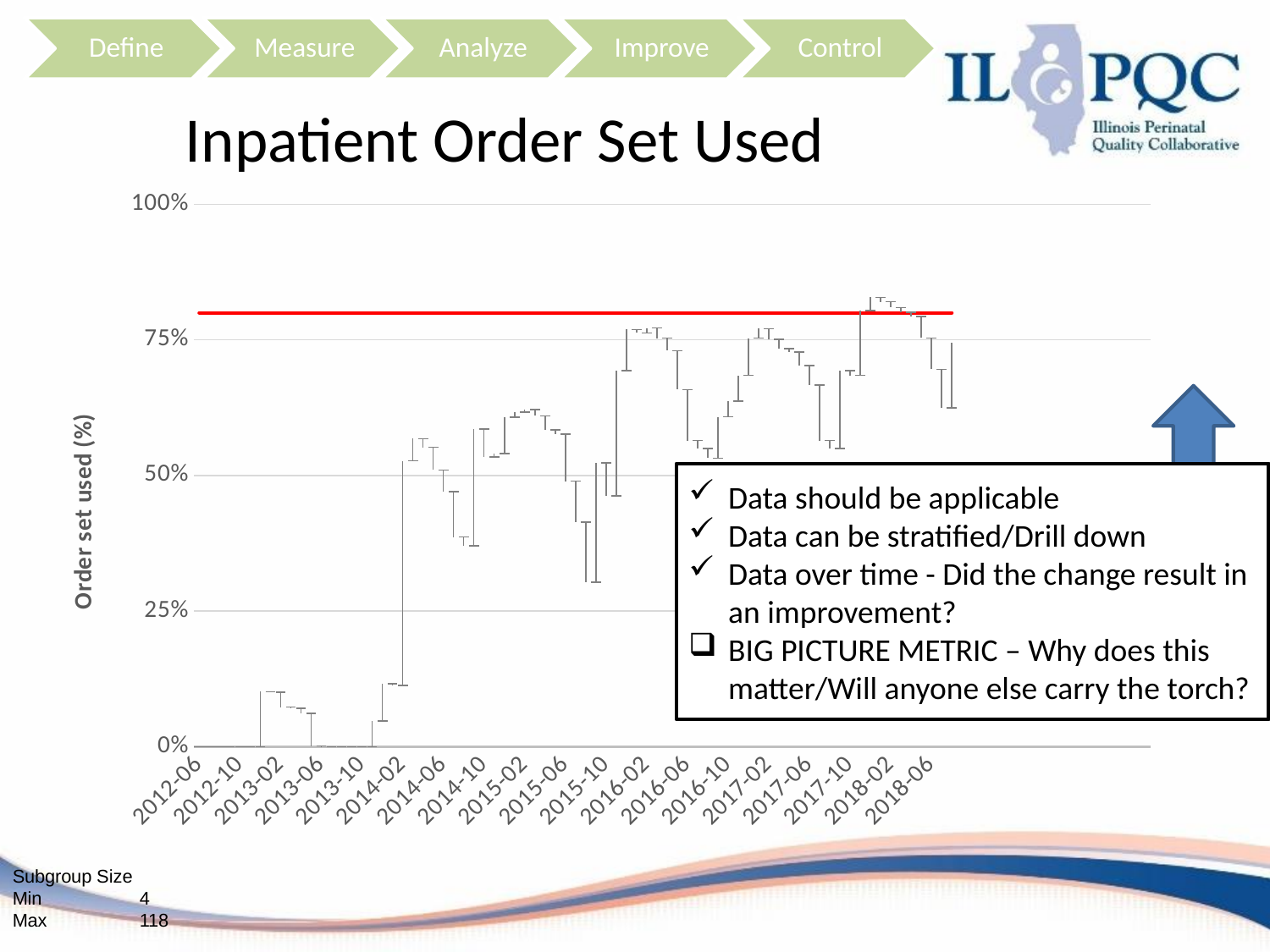
What is the last date label on the horizontal axis of the chart? 2018-06 Is the value for 2018-02 greater or less than 75%? greater What is the maximum subgroup size listed on the slide? 118 What is the label of the vertical axis of the chart? Order set used (%) What kind of chart is shown on the slide? line chart Is the value for 2013-02 greater or less than 25%? less Is the value for 2015-02 greater or less than 50%? greater What is the highest value shown on the vertical axis of the chart? 100% What is the title of the chart on the slide? Inpatient Order Set Used How many percentage tick labels are shown on the vertical axis of the chart? 5 What is the first date label on the horizontal axis of the chart? 2012-06 Overall, do the plotted values rise or fall from 2012-06 to 2018-06? rise